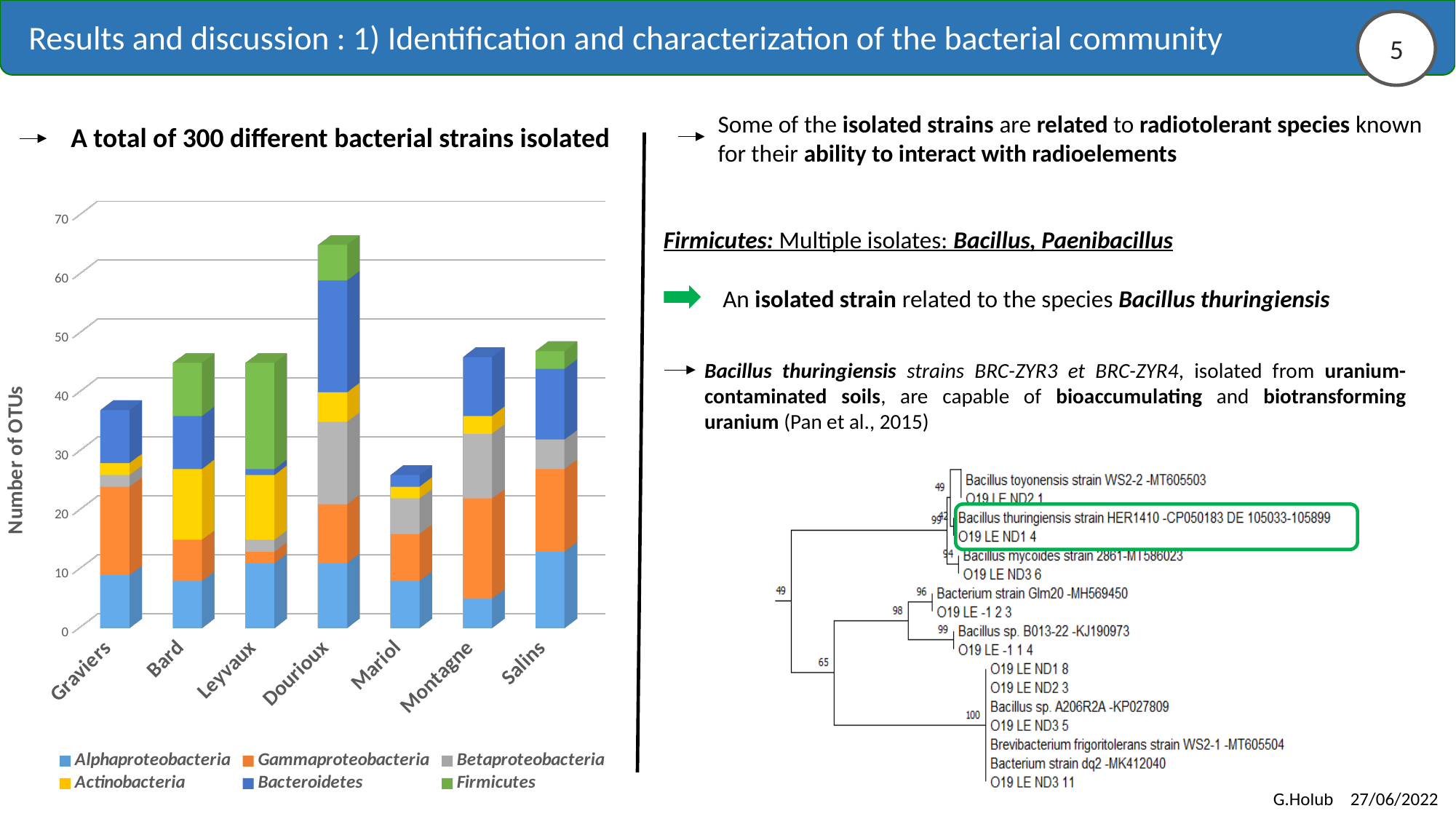
Which site has the largest Firmicutes segment in the bar chart? Leyvaux Is the total number of OTUs for Mariol greater or less than 30? less How many series does the legend of the bar chart list? 6 What is the title of the y axis of the bar chart? Number of OTUs Which colour represents Gammaproteobacteria in the bar chart legend? Orange How many sites (categories) are shown on the x axis of the bar chart? 7 Is the total number of OTUs for Dourioux greater or less than 60? greater Which has a larger total number of OTUs, Bard or Mariol? Bard Is the total number of OTUs for Graviers greater or less than 40? less Which site has the lowest total number of OTUs in the bar chart? Mariol Which site has the highest total number of OTUs in the bar chart? Dourioux What kind of chart is shown on the left of the slide? Stacked bar chart